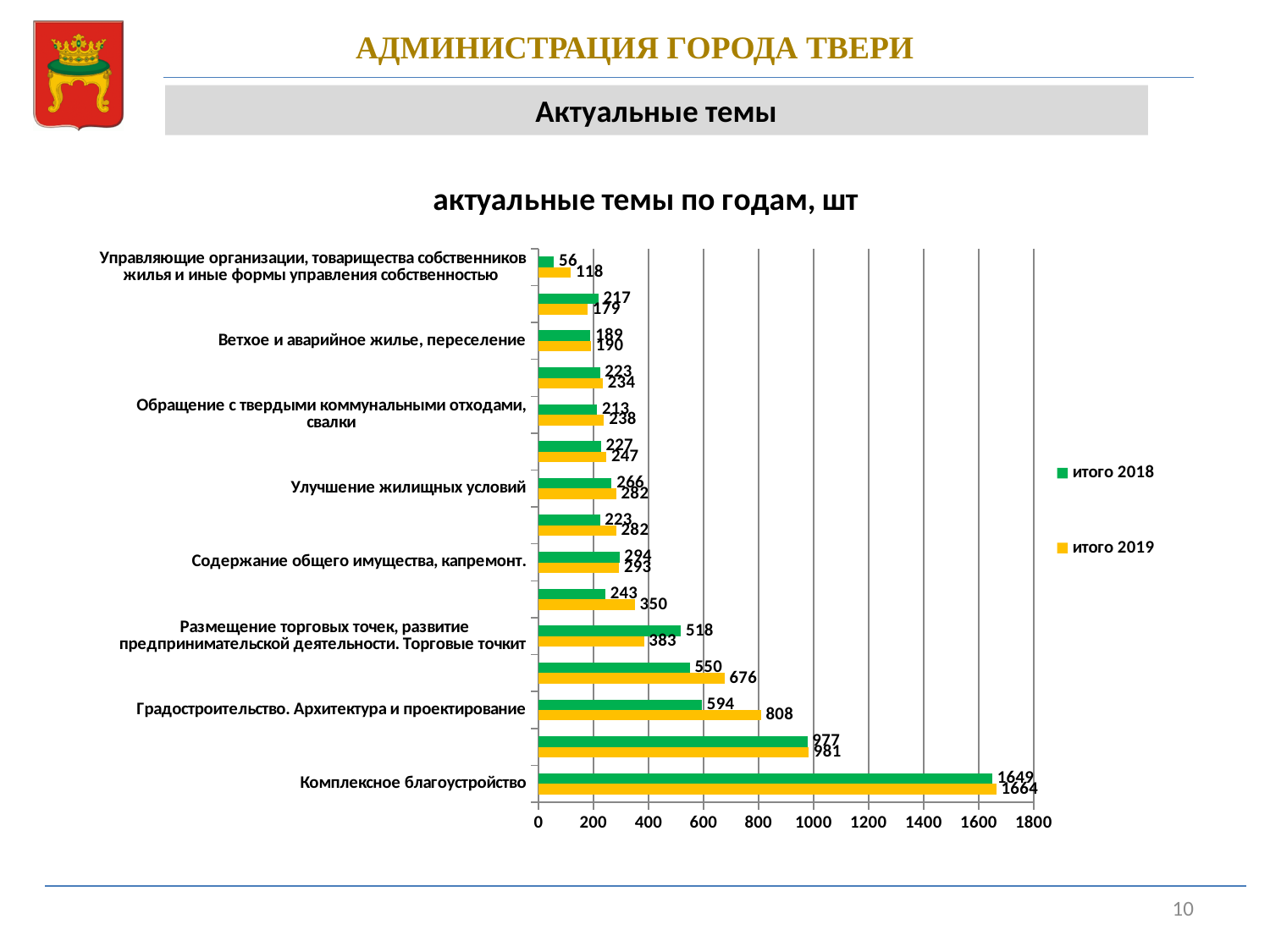
Which category has the highest value in the итого 2019 series? Комплексное благоустройство Which category has the lowest value in the итого 2018 series? Управляющие организации, товарищества собственников жилья и иные формы управления собственностью What is the value for Управляющие организации, товарищества собственников жилья и иные формы управления собственностью in the итого 2018 series? 56 What is the value for Улучшение жилищных условий in the итого 2019 series? 282 What kind of chart is shown on the slide? bar chart How many series does the legend list? 2 What is the value for Комплексное благоустройство in the итого 2018 series? 1649 What is the difference between the итого 2019 and итого 2018 values for Комплексное благоустройство? 15 What is the difference between the итого 2019 and итого 2018 values for Градостроительство. Архитектура и проектирование? 214 What is the value for Градостроительство. Архитектура и проектирование in the итого 2019 series? 808 For Размещение торговых точек, развитие предпринимательской деятельности. Торговые точки, which series has the larger value, итого 2018 or итого 2019? итого 2018 What is the title of the chart? актуальные темы по годам, шт